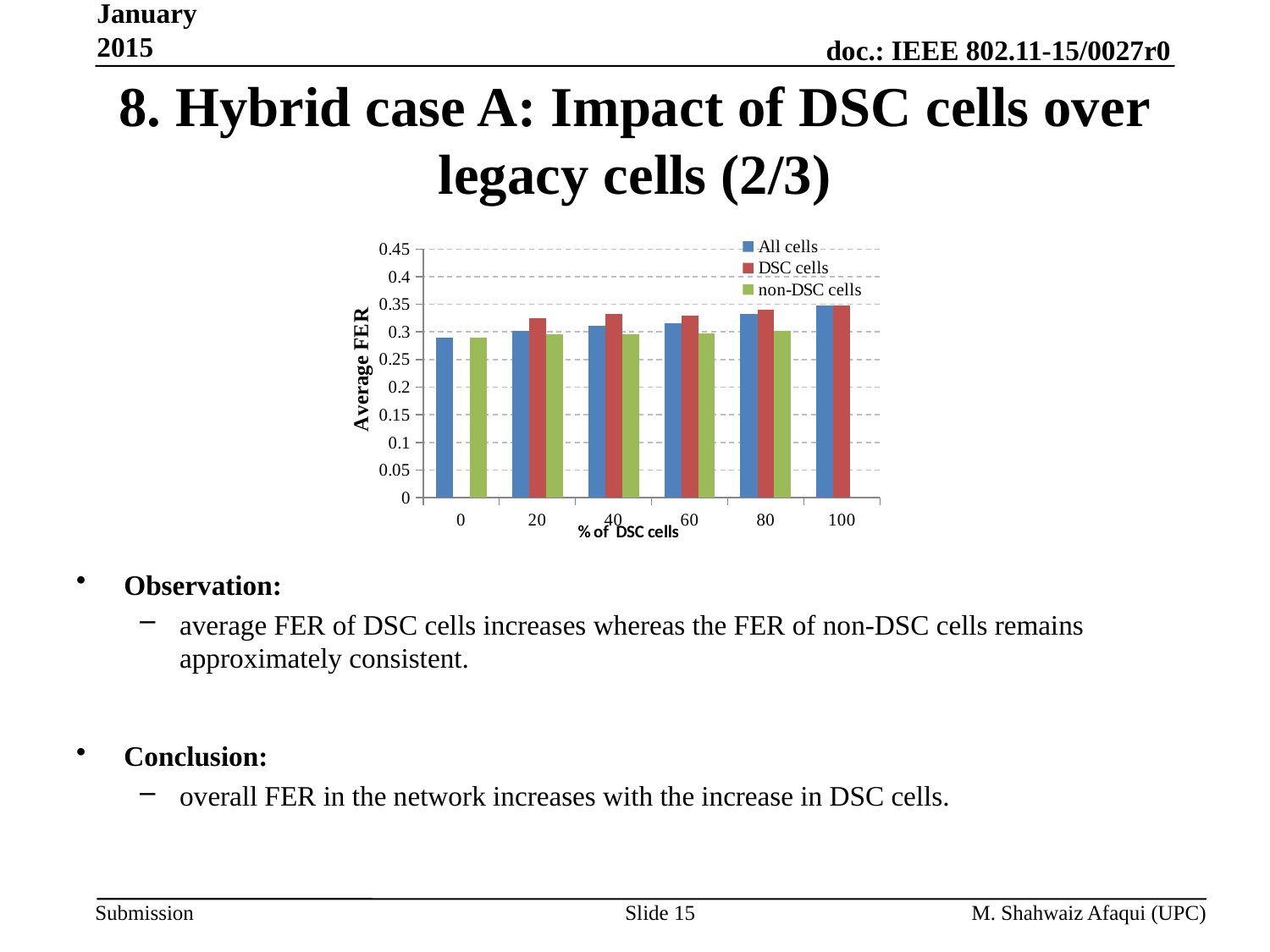
Do the values for All cells rise or fall as the % of DSC cells increases from 0 to 100? rise Is the value for All cells at 100% of DSC cells greater or less than 0.3? greater What is the label of the y axis? Average FER How many series does the legend list? 3 Which series are listed in the legend? All cells, DSC cells, non-DSC cells Is the value for DSC cells at 20% of DSC cells greater or less than 0.35? less How many categories are shown along the x axis (% of DSC cells)? 6 At 80% of DSC cells, which is larger: DSC cells or non-DSC cells? DSC cells What kind of chart is shown on the slide? bar chart At which % of DSC cells is the All cells value highest? 100 Is the value for DSC cells at 80% of DSC cells greater or less than 0.3? greater